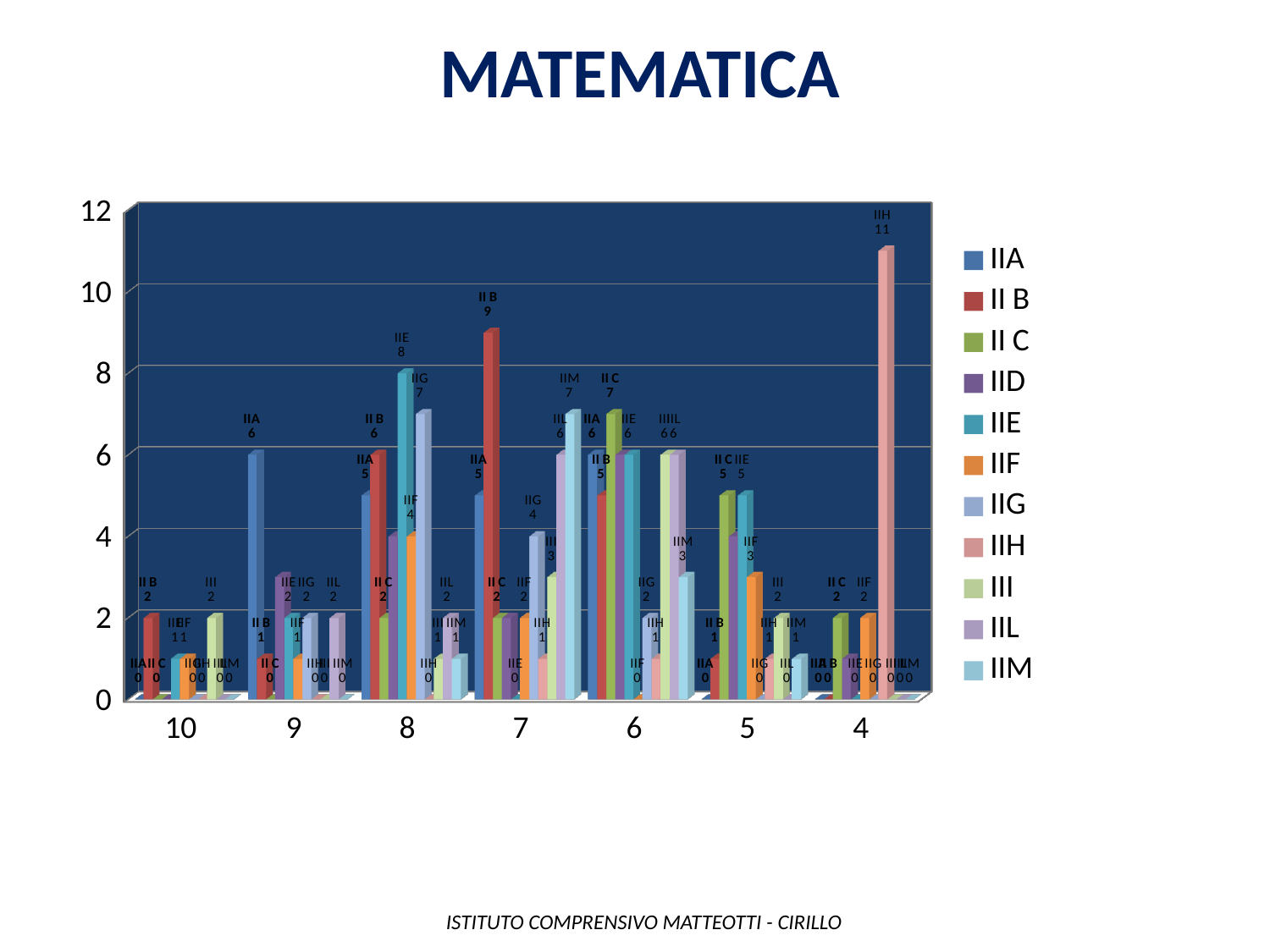
What is the value for IIA in category 9? 6 What is the title of the chart? MATEMATICA How many categories are shown along the x axis? 7 What is the value for II B in category 7? 9 Is the value for IIH in category 4 greater or less than 10? greater What kind of chart is shown on the slide? bar chart What is the difference between the value for IIH in category 4 and the value for II B in category 7? 2 What is the value for IIH in category 4? 11 How many series does the legend list? 11 What is the value for IIE in category 8? 8 Which series has the tallest bar in the whole chart? IIH Which is larger: the value for IIA in category 9 or the value for IIA in category 8? category 9